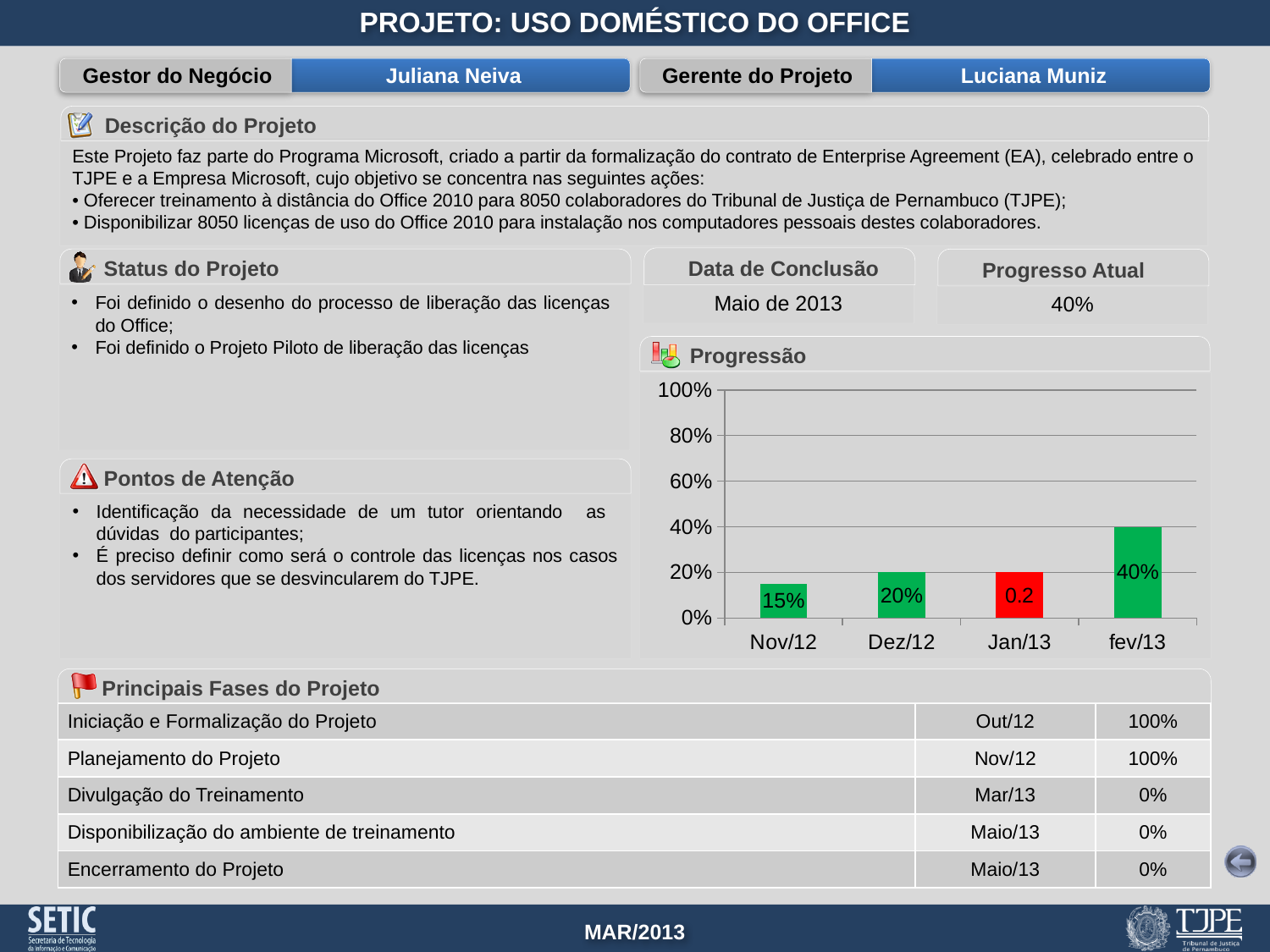
What is the value shown for Dez/12 in the Progressão chart? 20% In the Progressão chart, which bar is coloured red? Jan/13 In the Progressão chart, what is the difference between the fev/13 value and the Nov/12 value? 25% What is the value shown for fev/13 in the Progressão chart? 40% What data label is printed on the Jan/13 bar in the Progressão chart? 0.2 What is the value shown for Nov/12 in the Progressão chart? 15% Which month has the highest value in the Progressão chart? fev/13 What kind of chart is the Progressão chart? bar chart In the Progressão chart, what is the difference between the Dez/12 value and the Nov/12 value? 5% Which month has the lowest value in the Progressão chart? Nov/12 In the Progressão chart, which is larger, the value for fev/13 or the value for Dez/12? fev/13 How many months are plotted in the Progressão chart? 4